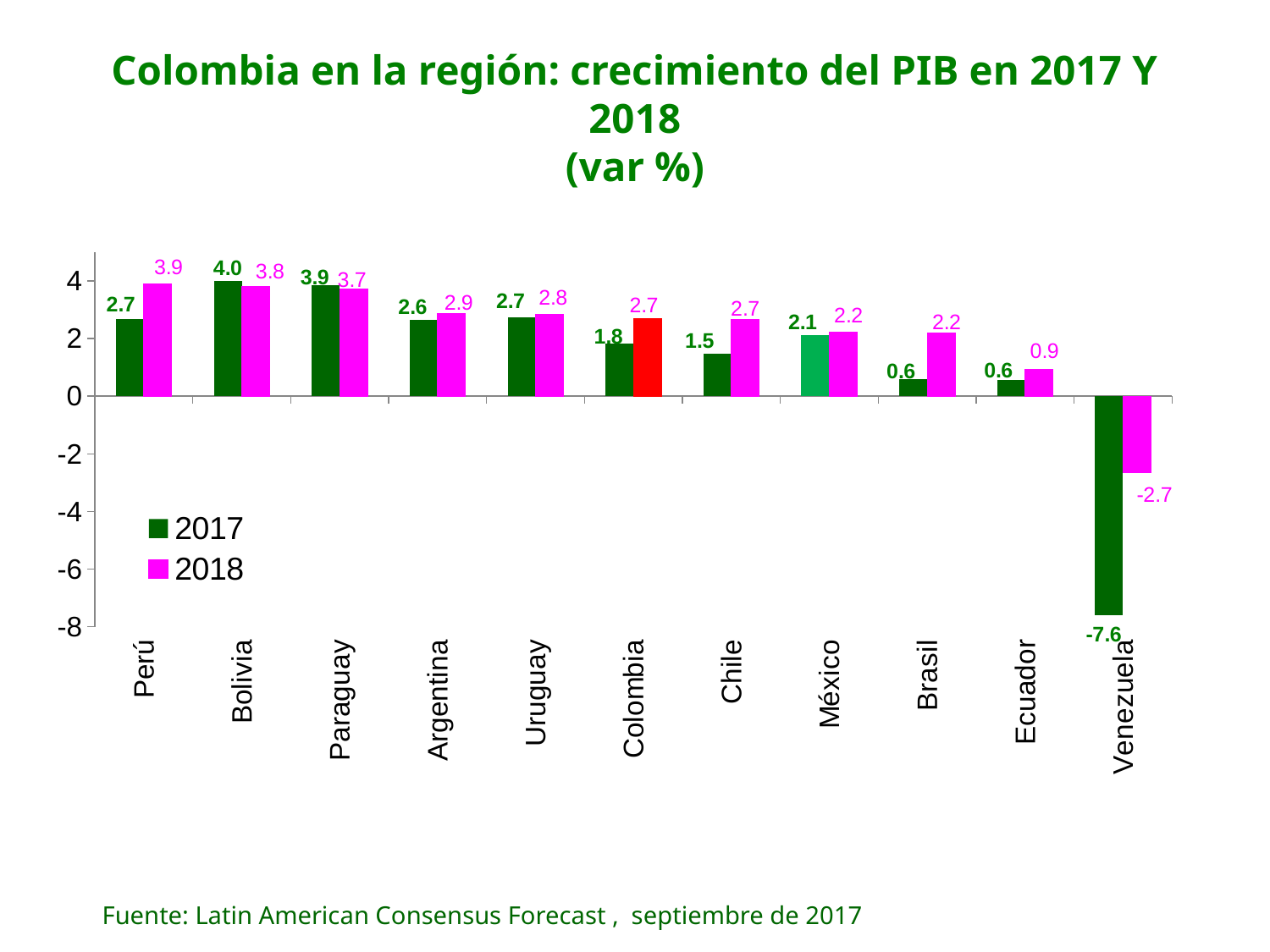
What is the 2017 value for Colombia? 1.8 Which country has the lowest 2018 value? Venezuela What is the difference between the 2018 and 2017 values for Chile? 1.2 Which is larger, the 2017 value for Paraguay or the 2017 value for Argentina? Paraguay What is the 2018 value for Venezuela? -2.7 How many countries are shown on the x axis? 11 What kind of chart is shown? bar chart Is the 2017 value for Venezuela greater or less than -6? less How many series does the legend list? 2 Which country has the highest 2017 value? Bolivia What source is cited below the chart? Latin American Consensus Forecast, septiembre de 2017 What is the 2018 value for Ecuador? 0.9